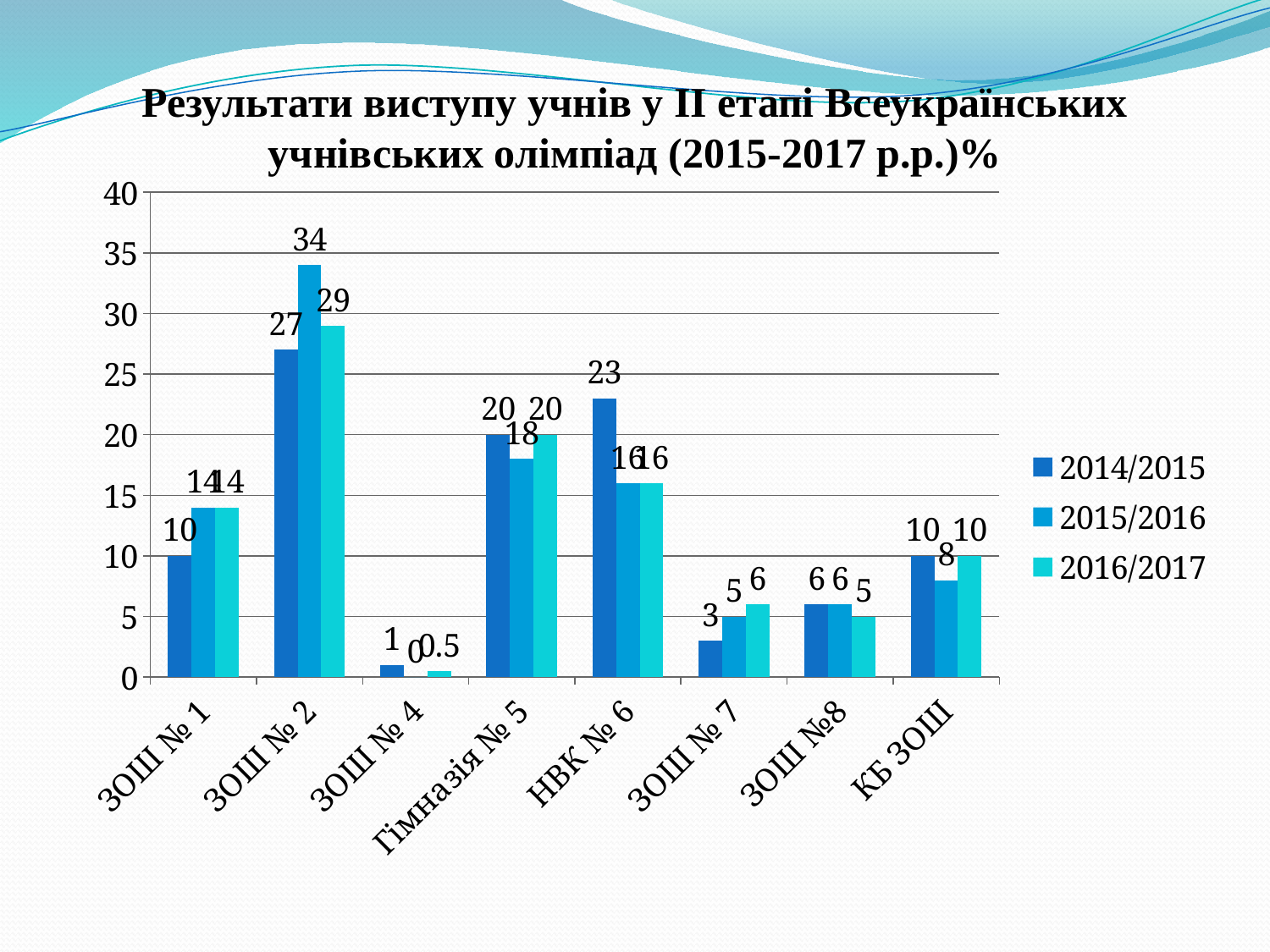
What is the difference between the 2015/2016 and 2014/2015 values for ЗОШ № 2? 7 Which category has the lowest value in the 2015/2016 series? ЗОШ № 4 Which category has the highest value in the 2014/2015 series? ЗОШ № 2 How many categories are shown on the x axis? 8 How many series does the legend list? 3 What is the value for ЗОШ № 4 in the 2016/2017 series? 0.5 Which is larger for Гімназія № 5: the 2014/2015 value or the 2015/2016 value? 2014/2015 Do the values for ЗОШ № 7 rise or fall from 2014/2015 to 2016/2017? Rise What kind of chart is shown on the slide? Bar chart What is the value for КБ ЗОШ in the 2015/2016 series? 8 What is the value for ЗОШ № 2 in the 2015/2016 series? 34 What is the value for НВК № 6 in the 2014/2015 series? 23